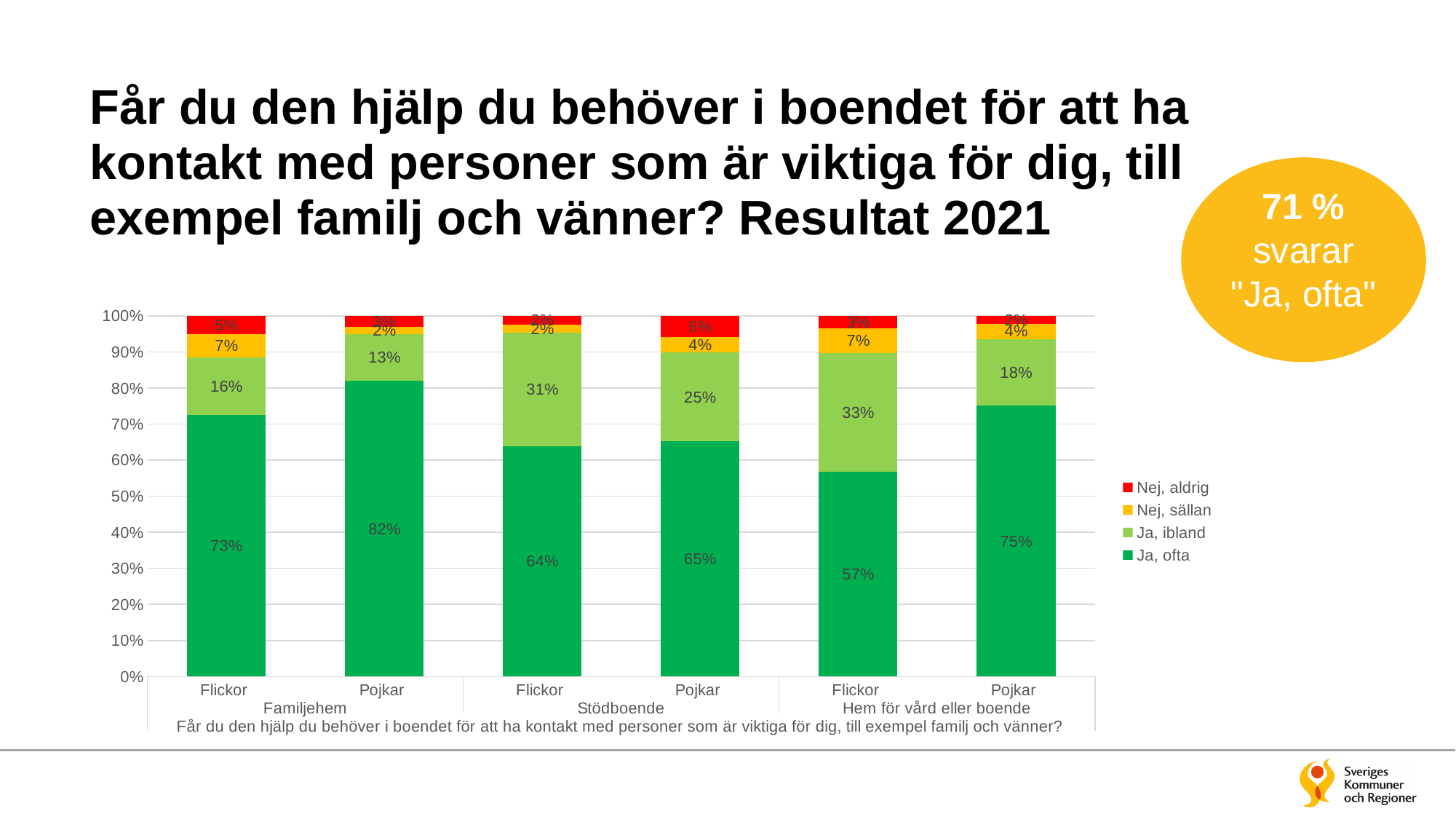
What percentage of Flickor in Hem för vård eller boende answered "Ja, ibland"? 33% Which legend entry is shown in red? Nej, aldrig What kind of chart is shown on the slide? Stacked bar chart What percentage of Flickor in Familjehem answered "Nej, sällan"? 7% What percentage of Pojkar in Stödboende answered "Nej, aldrig"? 6% What is the difference in the "Ja, ofta" share between Pojkar and Flickor in Hem för vård eller boende? 18 percentage points Which group has the highest share of "Ja, ofta" answers? Pojkar, Familjehem How many series does the legend list? 4 What percentage of Pojkar in Familjehem answered "Ja, ofta"? 82% Which group has the lowest share of "Ja, ofta" answers? Flickor, Hem för vård eller boende How many bars are shown in the chart? 6 Which has a larger "Ja, ibland" share: Flickor in Stödboende or Pojkar in Stödboende? Flickor in Stödboende